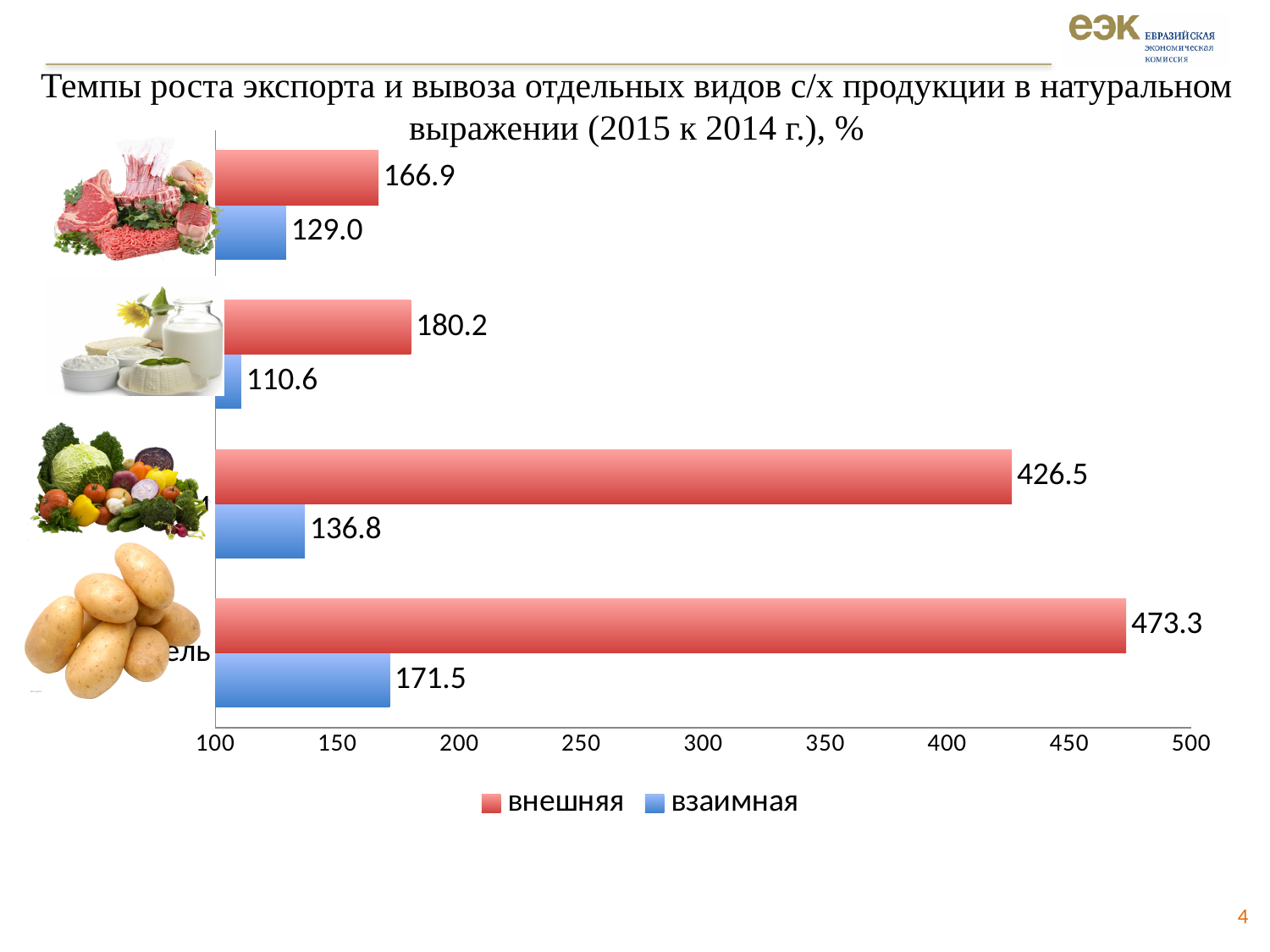
Which colour represents the внешняя series in the chart? red Which is larger: the внешняя value for the top category (meat) or the внешняя value for the second category (dairy)? the second category (dairy), 180.2 How many categories (product groups) are plotted in the chart? 4 For the third category from the top (vegetables), what is the difference between the внешняя and взаимная values? 289.7 What kind of chart is shown on the slide? bar chart How many series does the legend list? 2 What is the внешняя value for the top category (the one with the meat image)? 166.9 What is the взаимная value for the second category from the top (the one with the dairy image)? 110.6 Which category has the highest внешняя value? the bottom category (potatoes), 473.3 For the bottom category (potatoes), what is the difference between the внешняя and взаимная values? 301.8 Which category has the lowest взаимная value? the second category from the top (dairy), 110.6 What is the внешняя value for the bottom category (the one with the potato image)? 473.3